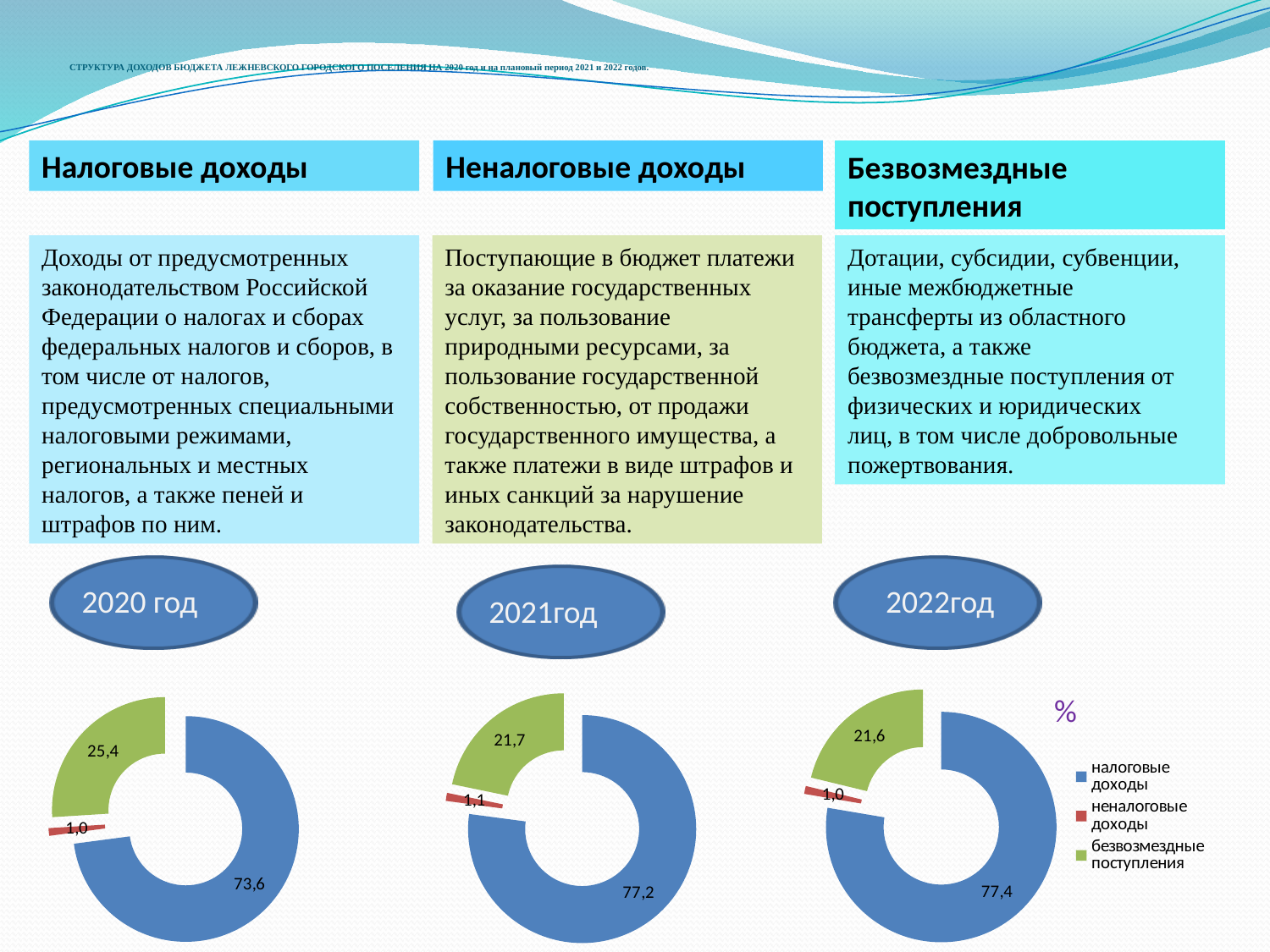
In the 2020 год chart, what is the difference between безвозмездные поступления and неналоговые доходы? 24,4 In the 2022год chart, what is the difference between налоговые доходы and безвозмездные поступления? 55,8 How many entries does the legend on the right list? 3 In the 2021год chart, which category has the smallest share? неналоговые доходы What type of chart is used for the 2021год data? doughnut chart How many categories does each doughnut chart show? 3 In the 2021год chart, what is the value for безвозмездные поступления? 21,7 Which colour represents неналоговые доходы in the charts? red Which is larger: безвозмездные поступления in the 2020 год chart or in the 2022год chart? 2020 год In the 2022год chart, what is the value for неналоговые доходы? 1,0 In the 2020 год chart, which category has the largest share? налоговые доходы In the 2020 год chart, what is the value for налоговые доходы? 73,6